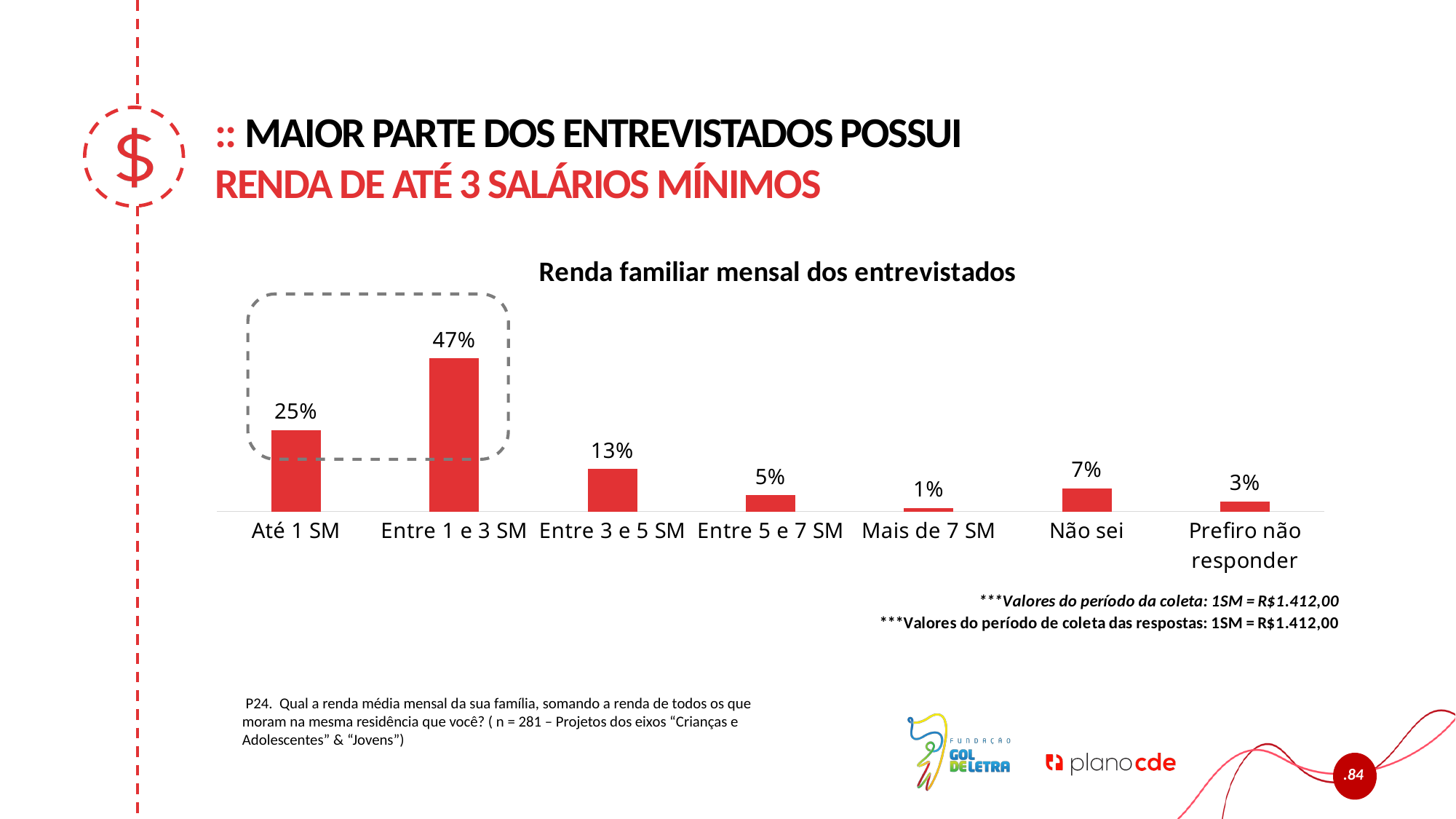
Which is larger, the value for "Entre 3 e 5 SM" or the value for "Não sei"? Entre 3 e 5 SM What is the value for "Até 1 SM"? 25% Which category has the highest value? Entre 1 e 3 SM What is the difference between the values for "Entre 1 e 3 SM" and "Até 1 SM"? 22% What is the combined value of "Até 1 SM" and "Entre 1 e 3 SM"? 72% What is the value for "Entre 1 e 3 SM"? 47% What is the value for "Prefiro não responder"? 3% How many categories are shown on the x axis? 7 Which category has the lowest value? Mais de 7 SM What kind of chart is shown on the slide? Bar chart What is the value for "Não sei"? 7% What is the title of the chart? Renda familiar mensal dos entrevistados